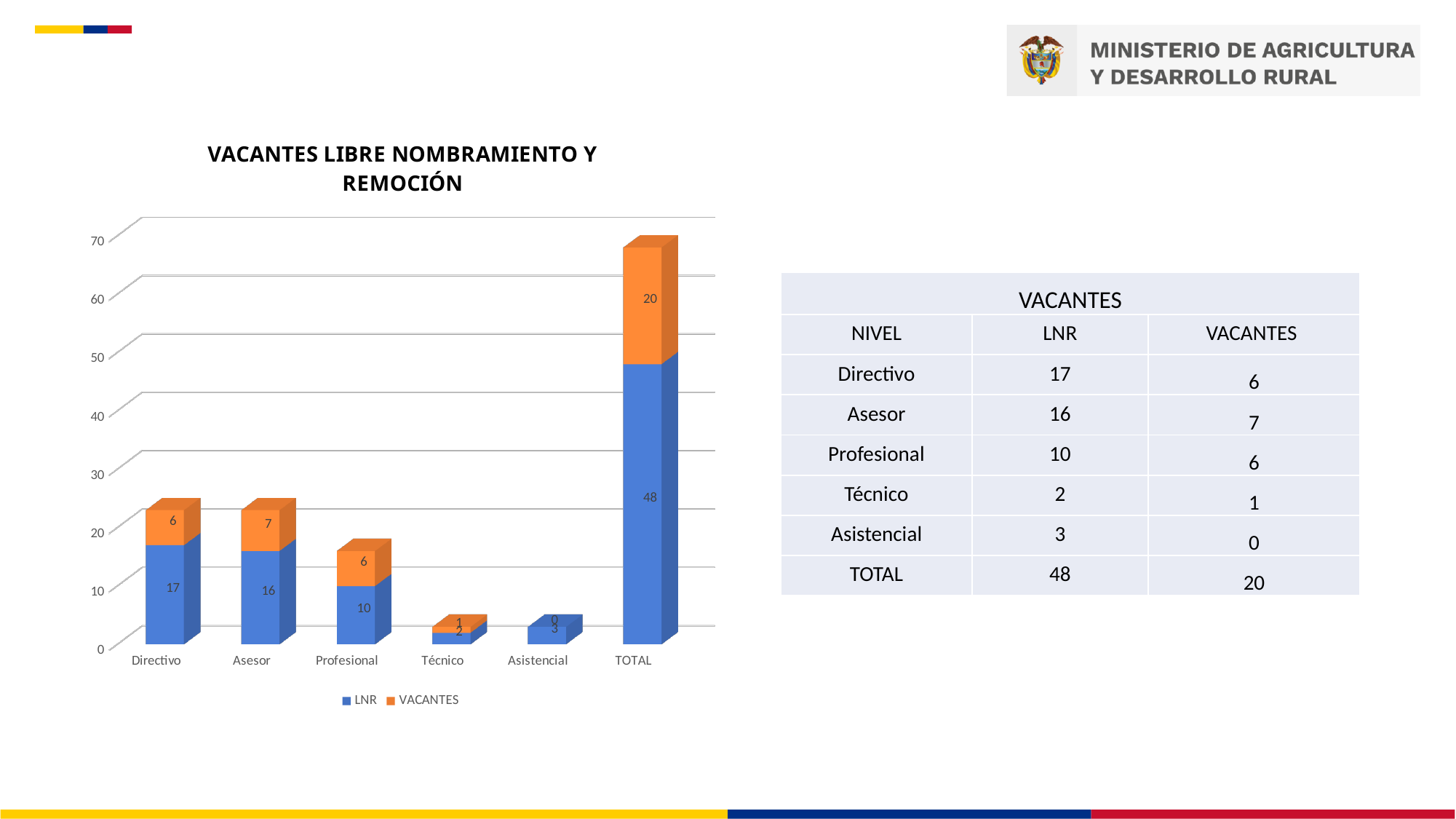
What is the LNR value for Profesional? 10 What is the total of the stacked bar for Profesional? 16 What is the difference between the LNR values for Directivo and Asesor? 1 Excluding the TOTAL bar, which category has the lowest LNR value? Técnico Which is larger, the VACANTES value for Asesor or for Profesional? Asesor What is the VACANTES value for Asesor? 7 What is the LNR value for Directivo? 17 How many series does the legend list? 2 How many categories are shown on the x axis? 6 What is the VACANTES value for Asistencial? 0 What kind of chart is shown on the slide? Stacked bar chart Excluding the TOTAL bar, which category has the highest LNR value? Directivo